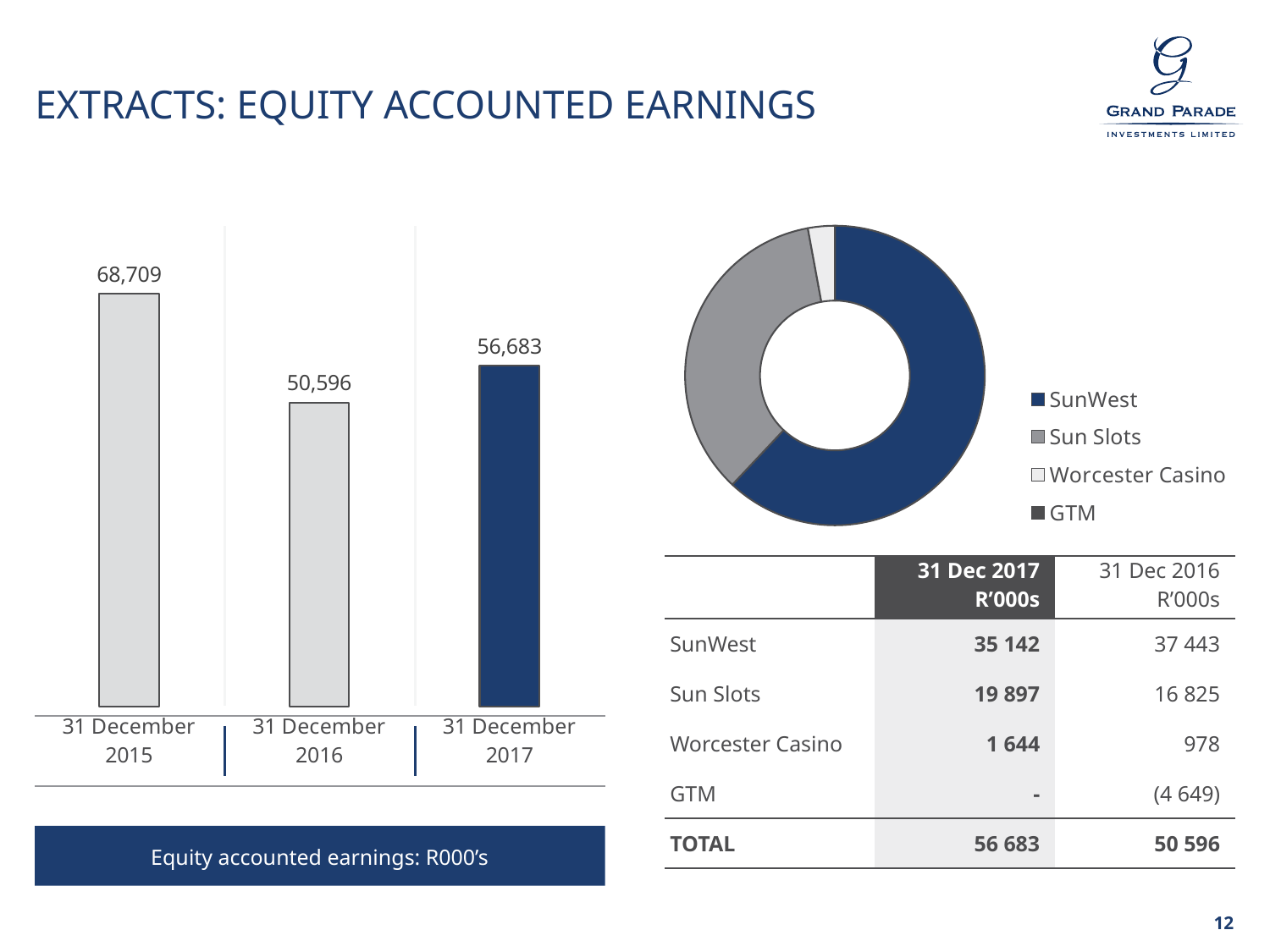
On the donut chart on the right, which segment is the largest? SunWest On the bar chart, what is the value for 31 December 2015? 68,709 On the bar chart, what is the value for 31 December 2017? 56,683 On the bar chart, which year has the highest value? 31 December 2015 On the bar chart, how many bars are shown? 3 On the bar chart, what is the difference between the values for 31 December 2017 and 31 December 2016? 6,087 On the bar chart, what is the value for 31 December 2016? 50,596 On the bar chart, which year has the lowest value? 31 December 2016 On the bar chart, what is the difference between the values for 31 December 2015 and 31 December 2016? 18,113 What kind of chart is on the left of the slide? Bar chart On the donut chart on the right, how many entries does the legend list? 4 On the bar chart, which is larger: the value for 31 December 2017 or 31 December 2016? 31 December 2017